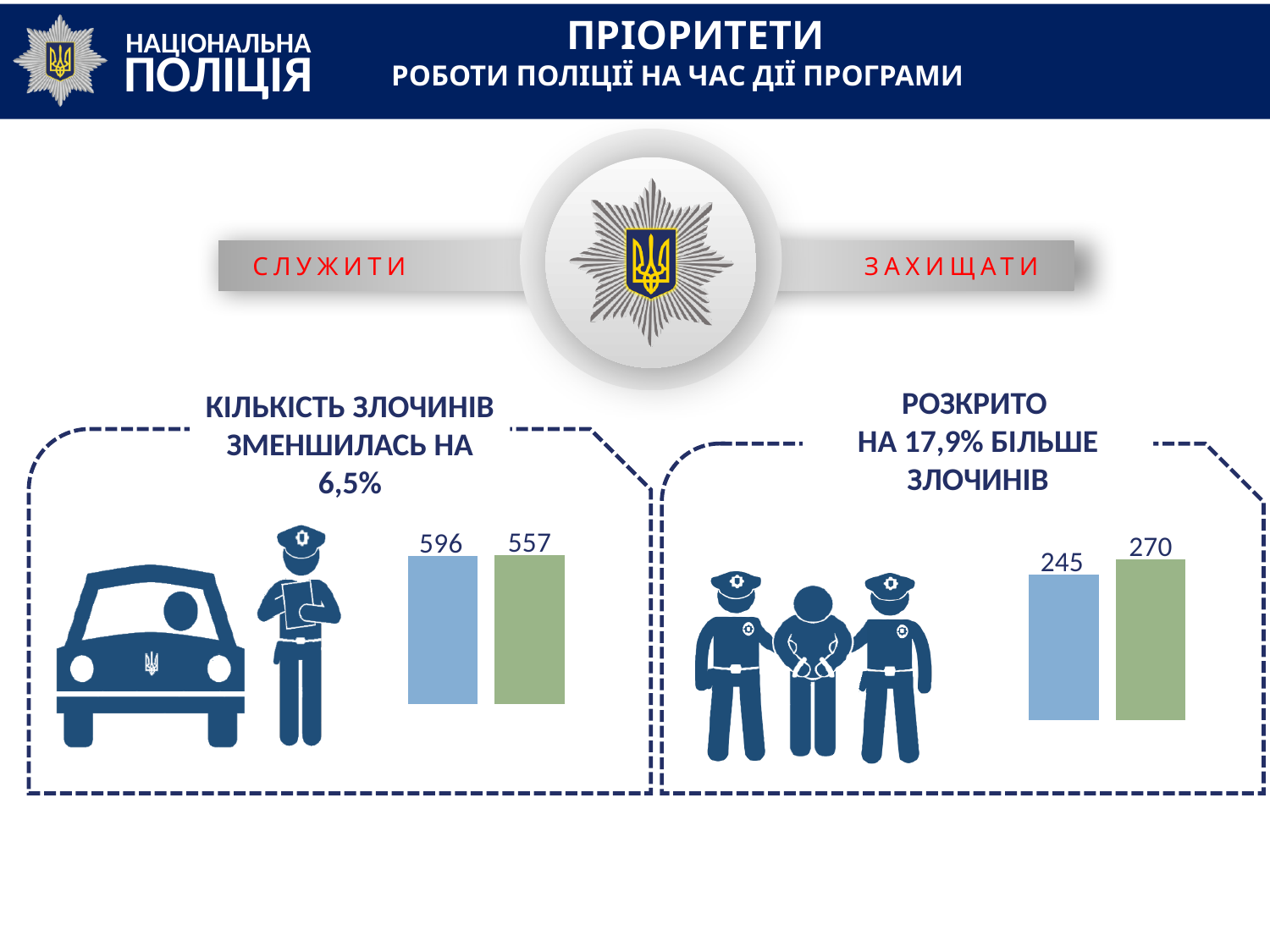
In the left chart (КІЛЬКІСТЬ ЗЛОЧИНІВ ЗМЕНШИЛАСЬ НА 6,5%), what value is printed above the green bar? 557 In the left chart (КІЛЬКІСТЬ ЗЛОЧИНІВ ЗМЕНШИЛАСЬ НА 6,5%), which bar has the larger printed value, the blue one or the green one? the blue one In the right chart (РОЗКРИТО НА 17,9% БІЛЬШЕ ЗЛОЧИНІВ), what value is printed above the blue bar? 245 In the left chart (КІЛЬКІСТЬ ЗЛОЧИНІВ ЗМЕНШИЛАСЬ НА 6,5%), what is the difference between the two printed values, 596 and 557? 39 How many bars does the left chart (КІЛЬКІСТЬ ЗЛОЧИНІВ ЗМЕНШИЛАСЬ НА 6,5%) contain? 2 What percentage is stated in the heading above the right chart? 17,9% In the right chart (РОЗКРИТО НА 17,9% БІЛЬШЕ ЗЛОЧИНІВ), what value is printed above the green bar? 270 In the left chart (КІЛЬКІСТЬ ЗЛОЧИНІВ ЗМЕНШИЛАСЬ НА 6,5%), what value is printed above the blue bar? 596 In the right chart (РОЗКРИТО НА 17,9% БІЛЬШЕ ЗЛОЧИНІВ), which bar has the larger printed value, the blue one or the green one? the green one What percentage is stated in the heading above the left chart? 6,5% In the right chart (РОЗКРИТО НА 17,9% БІЛЬШЕ ЗЛОЧИНІВ), what is the difference between the two printed values, 270 and 245? 25 What kind of chart is shown in the right box (РОЗКРИТО НА 17,9% БІЛЬШЕ ЗЛОЧИНІВ)? bar chart